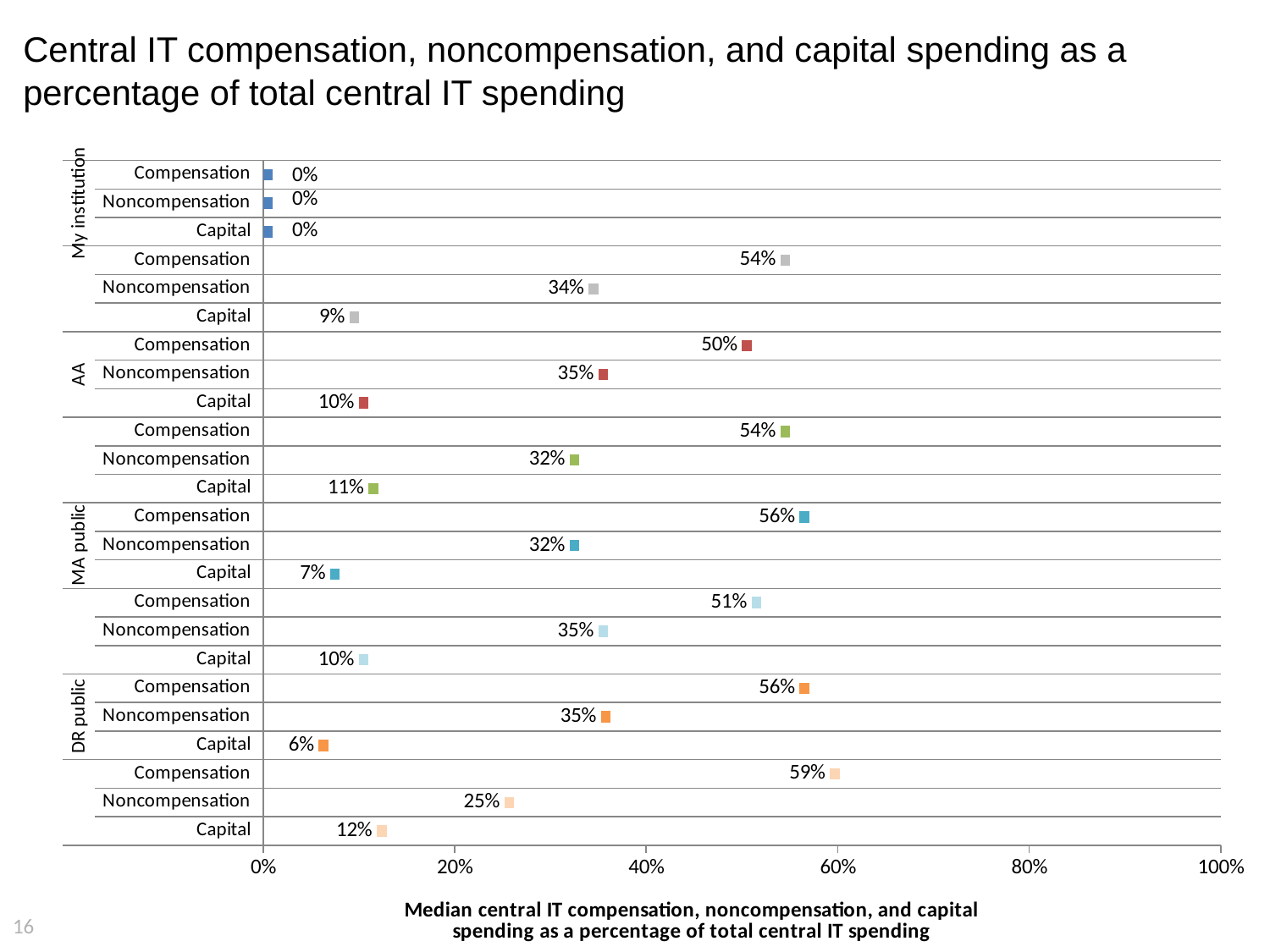
What is the highest value shown on the horizontal axis? 100% What is the Capital value for My institution? 0% What is the title of the horizontal axis? Median central IT compensation, noncompensation, and capital spending as a percentage of total central IT spending Within the AA group, which category has the lowest value? Capital Within the MA public group, which category has the highest value? Compensation What is the Capital value for DR public? 6% What is the Noncompensation value for MA public? 32% What is the Compensation value for DR public? 56% Which is larger, the Capital value for AA or the Capital value for MA public? Capital for AA What is the difference between the Compensation and Noncompensation values for AA? 15% What is the Compensation value for AA? 50% Is the Compensation value for DR public greater or less than 40%? greater